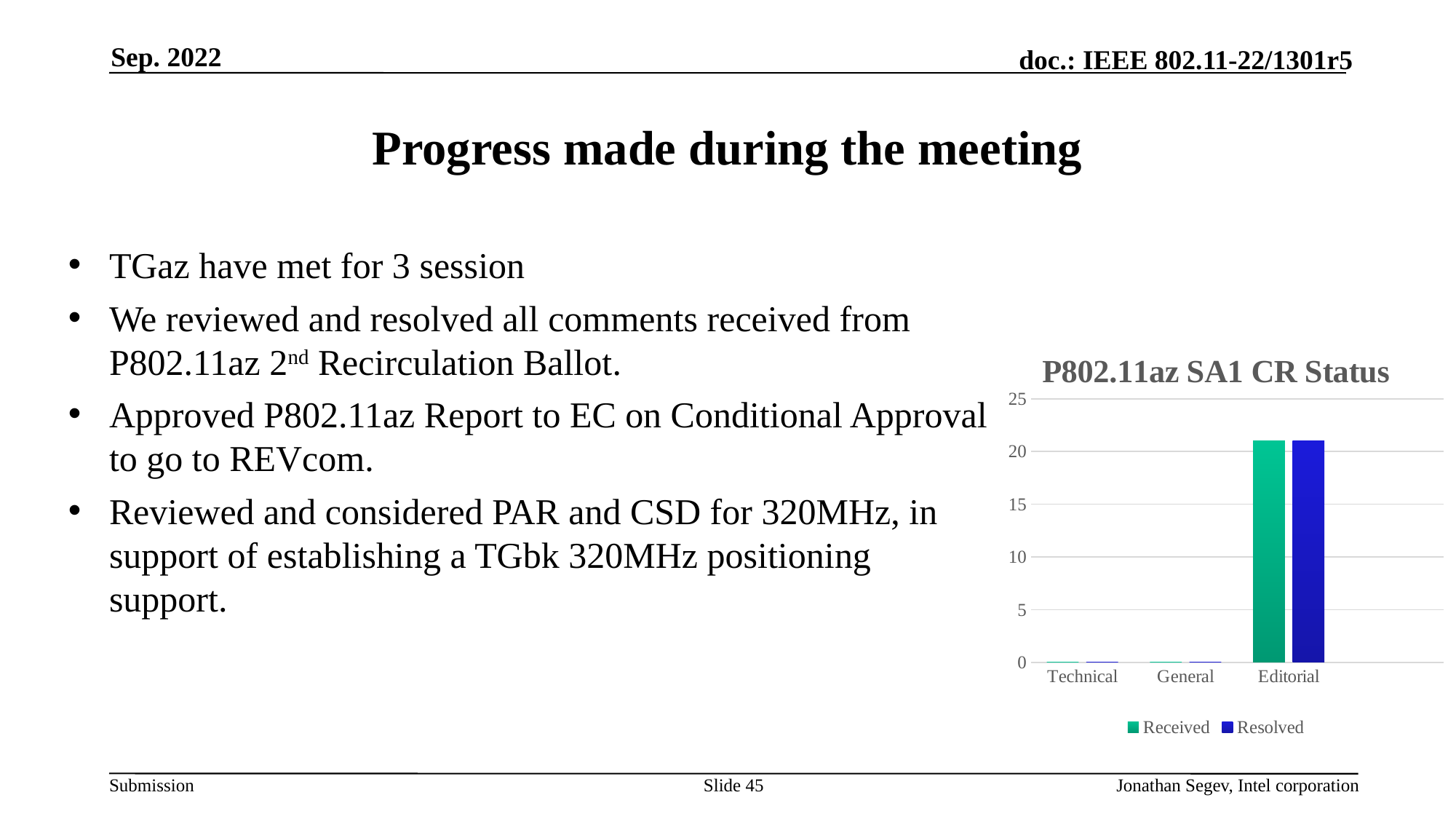
Which category has the highest Resolved value in the chart? Editorial Is the Received value for Editorial greater or less than 15? greater Which category has the highest Received value in the chart? Editorial What is the title of the chart on the slide? P802.11az SA1 CR Status What kind of chart is shown on the slide? bar chart How many categories are shown on the x axis of the chart? 3 Is the Received value for Technical greater or less than 5? less What is the highest value shown on the chart's y axis? 25 Is the Resolved value for Editorial greater or less than 25? less Which is larger, the Received value for Editorial or the Received value for General? Editorial Which series in the chart is shown in blue? Resolved How many series does the chart's legend list? 2